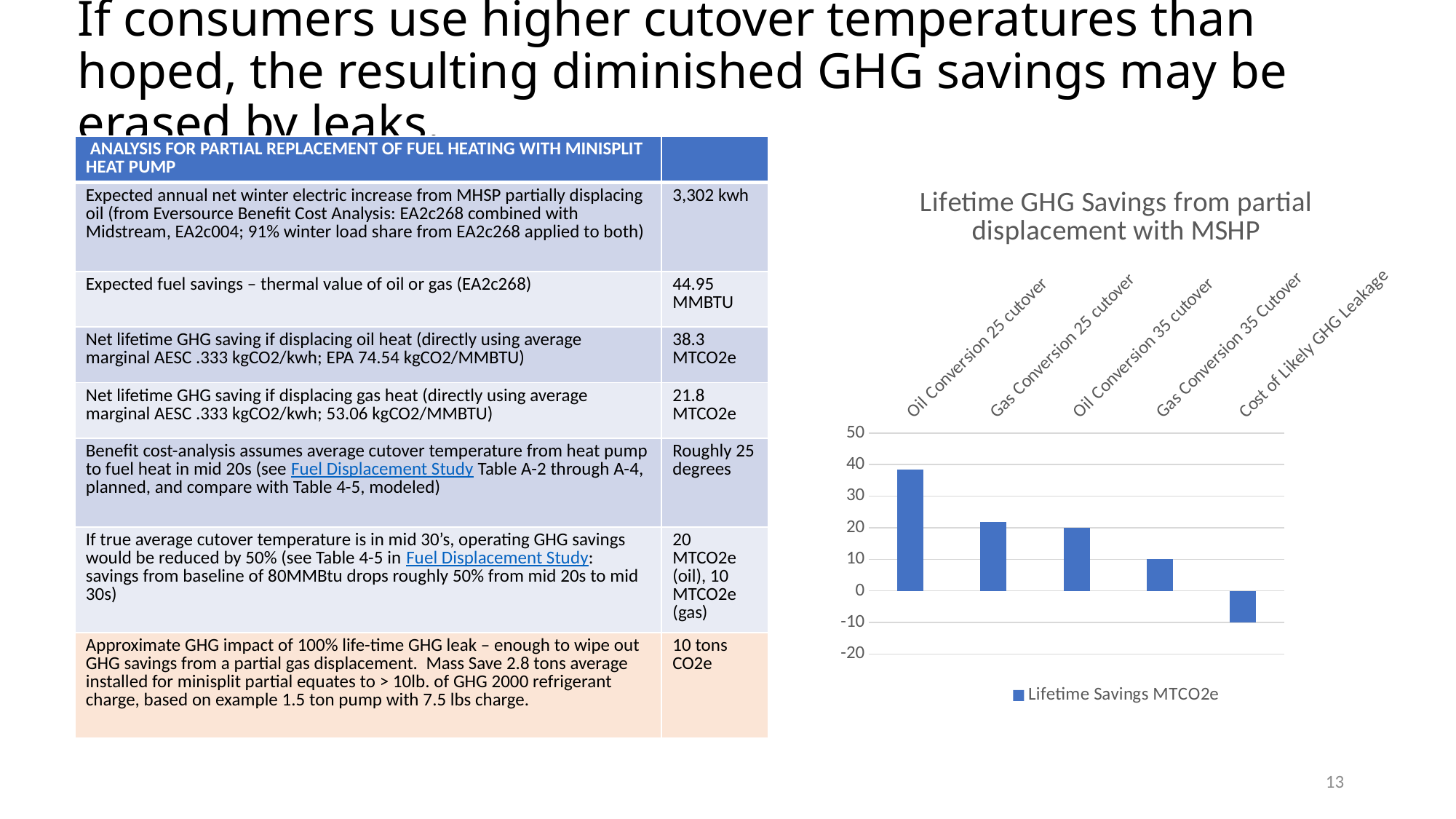
Is the value for Cost of Likely GHG Leakage greater or less than 0? less Is the value for Gas Conversion 25 cutover greater or less than 30? less Which is larger in the chart: Oil Conversion 25 cutover or Gas Conversion 25 cutover? Oil Conversion 25 cutover How many categories are plotted in the chart? 5 Do the bar values rise or fall moving from left to right across the chart? fall Is the value for Oil Conversion 25 cutover greater or less than 30? greater How many series does the chart legend list? 1 What is the legend entry for the series in the chart? Lifetime Savings MTCO2e Which category has the highest value in the chart? Oil Conversion 25 cutover Which category has the lowest value in the chart? Cost of Likely GHG Leakage What is the title of the chart on the slide? Lifetime GHG Savings from partial displacement with MSHP What kind of chart is shown on the slide? bar chart